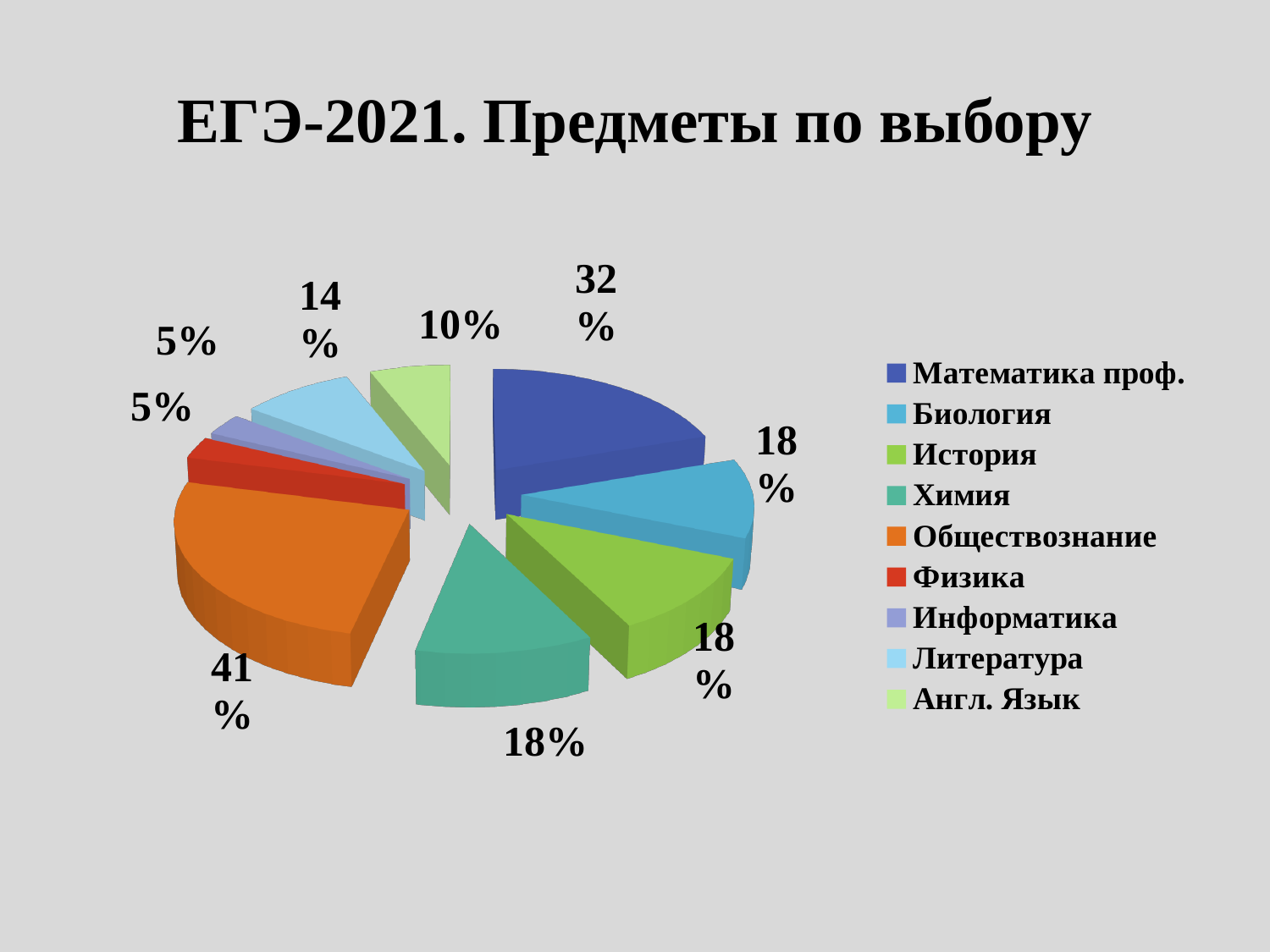
What percentage is shown for Литература? 14% Which colour represents Химия in the legend? Teal (green-blue) What percentage is shown for Англ. Язык? 10% What percentage is shown for Физика? 5% What is the title of the chart? ЕГЭ-2021. Предметы по выбору What percentage is shown for Математика проф.? 32% Which is larger, the value for Математика проф. or the value for Биология? Математика проф. Which subject has the largest slice of the pie? Обществознание What percentage is shown for Обществознание? 41% What is the difference between the percentages for Обществознание and Математика проф.? 9% How many subjects (categories) does the pie chart show? 9 What type of chart is shown on the slide? Pie chart